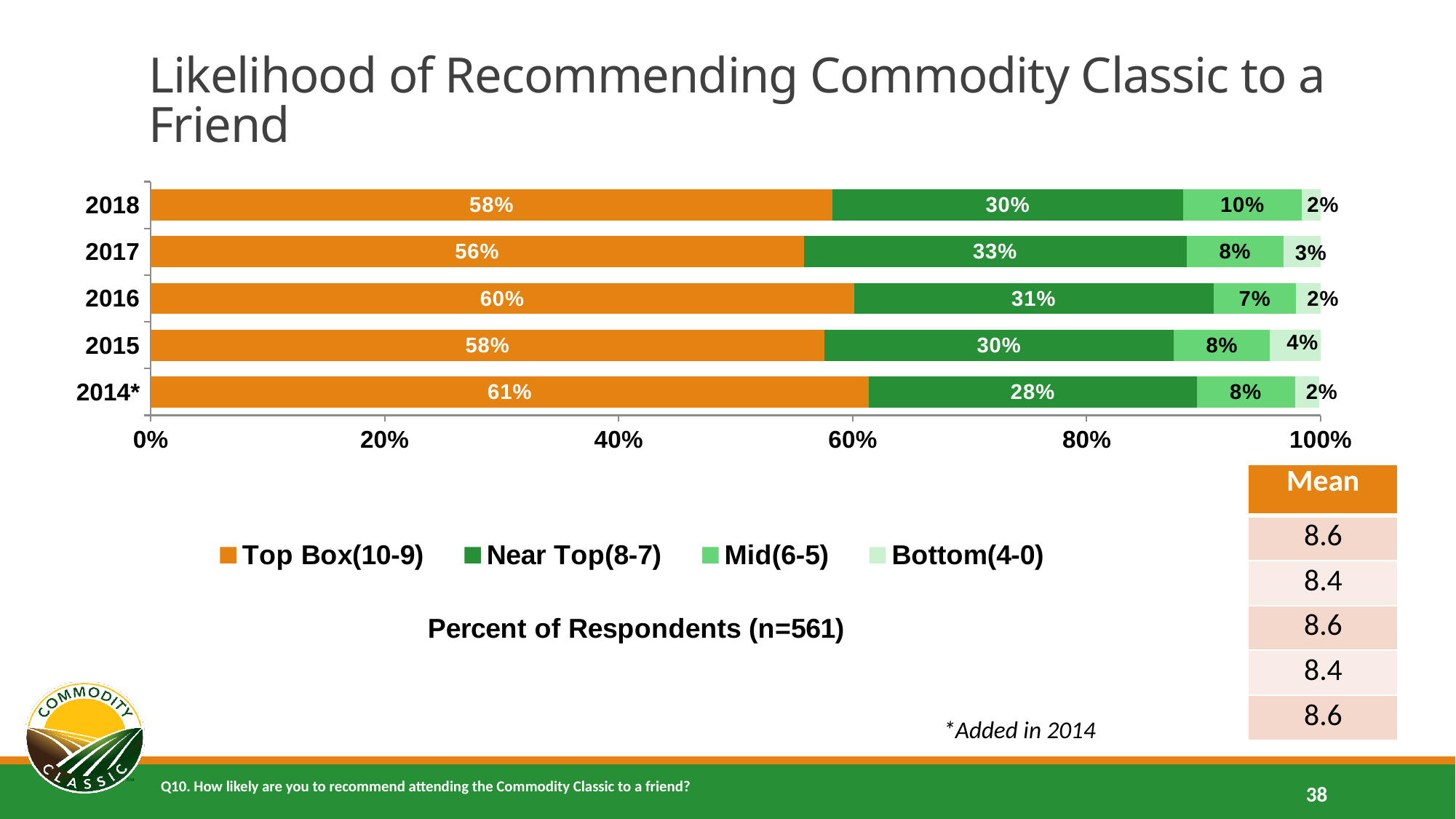
What is the Near Top(8-7) value for 2017? 33% What is the difference between the Top Box(10-9) values for 2016 and 2017? 4% What type of chart is shown on the slide? Stacked bar chart What is the Bottom(4-0) value for 2015? 4% Which is larger, the Near Top(8-7) value for 2017 or for 2014*? 2017 Which year has the highest Top Box(10-9) value? 2014* What is the x-axis label of the chart? Percent of Respondents (n=561) What is the Mid(6-5) value for 2016? 7% How many series does the legend list? 4 Which year has the lowest Top Box(10-9) value? 2017 How many years are shown on the chart? 5 What is the Top Box(10-9) value for 2018? 58%